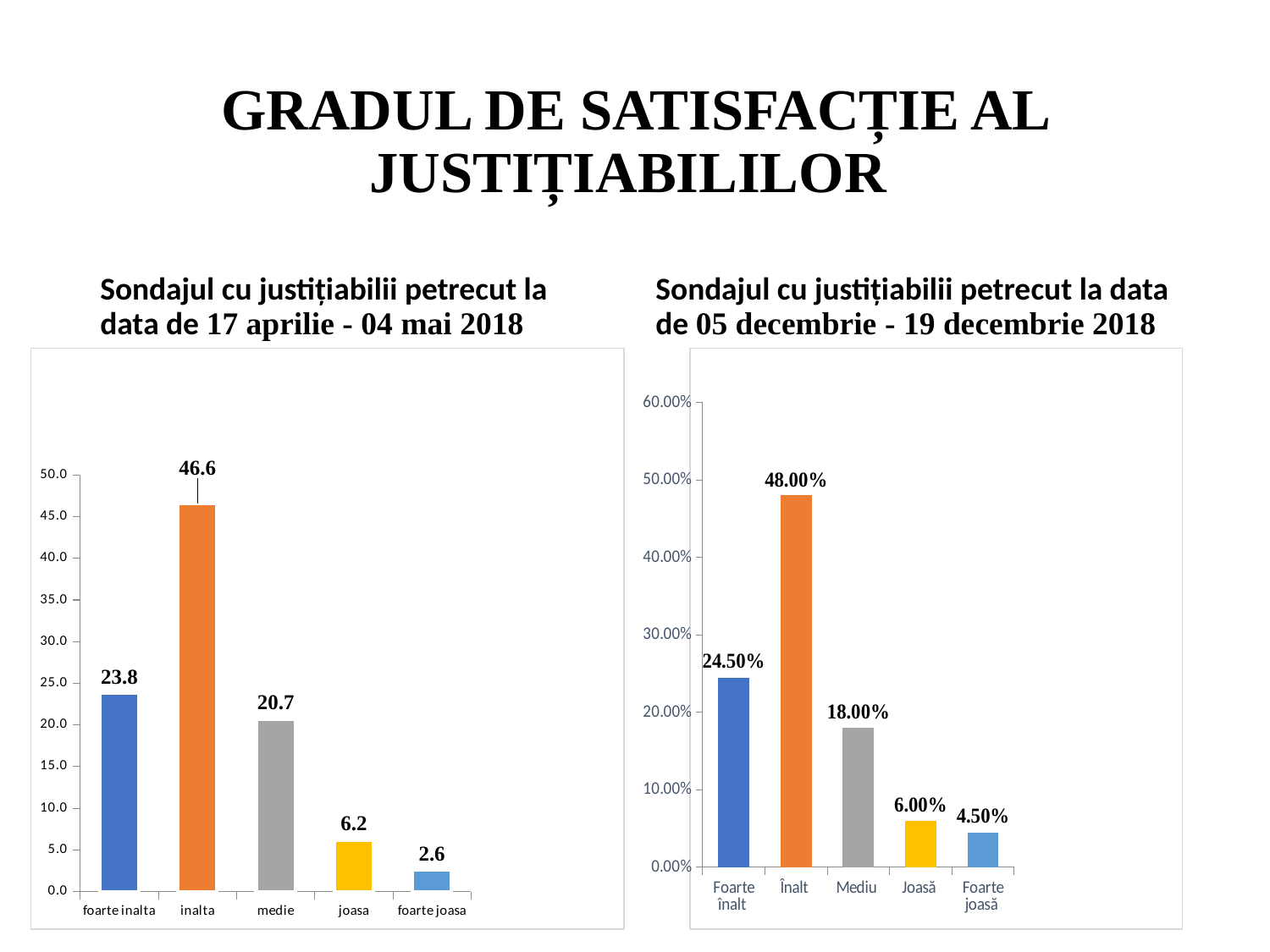
What kind of chart is the right chart (05 decembrie - 19 decembrie 2018)? bar chart In the right chart (05 decembrie - 19 decembrie 2018), what is the value for "Mediu"? 18.00% How many categories are shown in the left chart (17 aprilie - 04 mai 2018)? 5 In the left chart (17 aprilie - 04 mai 2018), what is the value for "joasa"? 6.2 In the left chart (17 aprilie - 04 mai 2018), what is the difference between the values for "inalta" and "foarte inalta"? 22.8 In the right chart (05 decembrie - 19 decembrie 2018), what is the difference between the values for "Joasă" and "Foarte joasă"? 1.50% In the right chart (05 decembrie - 19 decembrie 2018), is the value for "Foarte înalt" greater or less than 20.00%? greater In the left chart (17 aprilie - 04 mai 2018), which is larger: the value for "foarte inalta" or the value for "medie"? foarte inalta In the right chart (05 decembrie - 19 decembrie 2018), which category has the highest value? Înalt In the left chart (17 aprilie - 04 mai 2018), what is the value for "inalta"? 46.6 What is the title of the right chart? Sondajul cu justițiabilii petrecut la data de 05 decembrie - 19 decembrie 2018 In the left chart (17 aprilie - 04 mai 2018), which category has the lowest value? foarte joasa